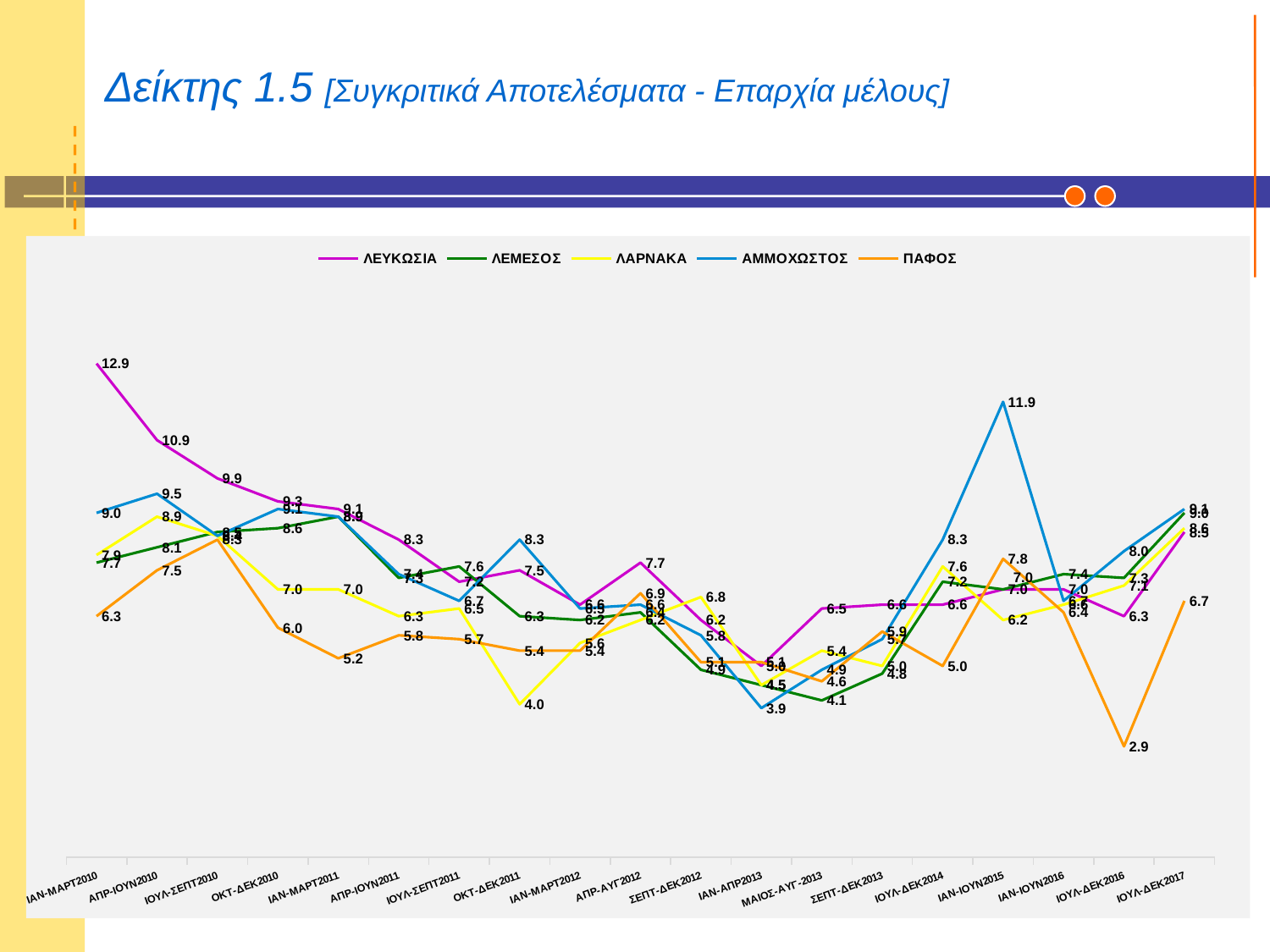
In ΙΑΝ-ΙΟΥΝ2015, which is larger: ΑΜΜΟΧΩΣΤΟΣ or ΠΑΦΟΣ? ΑΜΜΟΧΩΣΤΟΣ What is the value for ΛΑΡΝΑΚΑ in ΟΚΤ-ΔΕΚ2011? 4.0 What is the value for ΛΕΥΚΩΣΙΑ in ΙΑΝ-ΜΑΡΤ2010? 12.9 Which series has the lowest value anywhere on the chart? ΠΑΦΟΣ What kind of chart is shown on the slide? line chart How many series does the legend list? 5 How many time periods are shown along the x axis? 19 Which series has the highest value anywhere on the chart? ΛΕΥΚΩΣΙΑ Does the ΛΕΥΚΩΣΙΑ line rise or fall from ΙΑΝ-ΜΑΡΤ2010 to ΙΟΥΛ-ΣΕΠΤ2010? fall What is the value for ΠΑΦΟΣ in ΙΟΥΛ-ΔΕΚ2016? 2.9 What is the value for ΑΜΜΟΧΩΣΤΟΣ in ΙΑΝ-ΙΟΥΝ2015? 11.9 What is the difference between the ΛΕΥΚΩΣΙΑ values in ΙΑΝ-ΜΑΡΤ2010 and ΑΠΡ-ΙΟΥΝ2010? 2.0